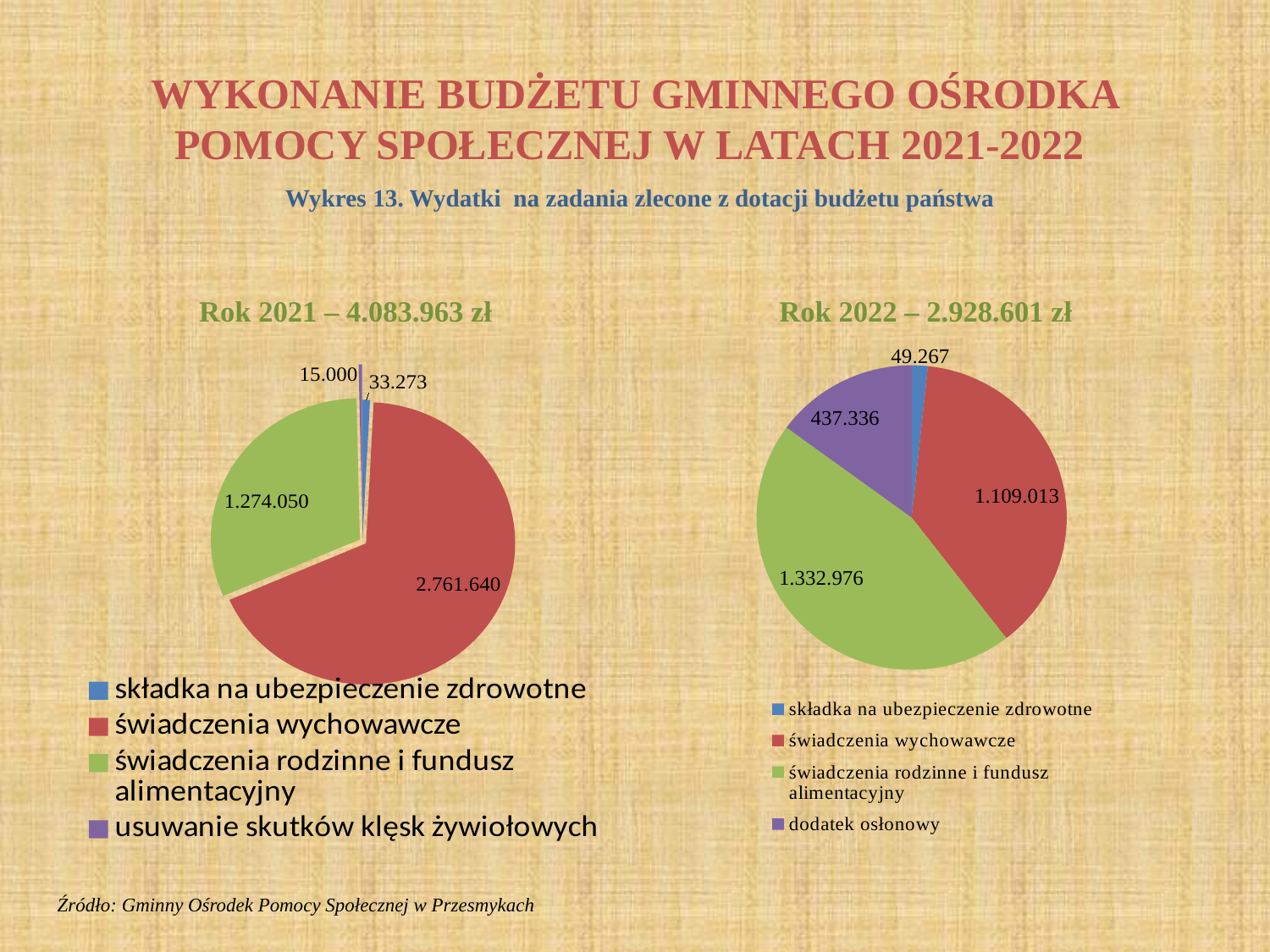
In the Rok 2021 pie chart, which category has the largest value? świadczenia wychowawcze In the Rok 2021 pie chart, what is the value for świadczenia wychowawcze? 2.761.640 In the Rok 2021 pie chart, what is the value for usuwanie skutków klęsk żywiołowych? 15.000 In the Rok 2021 pie chart, what is the value for świadczenia rodzinne i fundusz alimentacyjny? 1.274.050 In the Rok 2022 pie chart, what is the value for dodatek osłonowy? 437.336 In the Rok 2022 pie chart, which is larger: świadczenia wychowawcze or świadczenia rodzinne i fundusz alimentacyjny? świadczenia rodzinne i fundusz alimentacyjny How many categories does the Rok 2022 pie chart show? 4 In the Rok 2022 pie chart, which category has the smallest value? składka na ubezpieczenie zdrowotne In the Rok 2022 pie chart, what is the value for składka na ubezpieczenie zdrowotne? 49.267 In the Rok 2021 pie chart, what is the difference between świadczenia wychowawcze and świadczenia rodzinne i fundusz alimentacyjny? 1.487.590 What type of chart is used for Rok 2021? pie chart In the Rok 2022 pie chart, which category has the largest value? świadczenia rodzinne i fundusz alimentacyjny